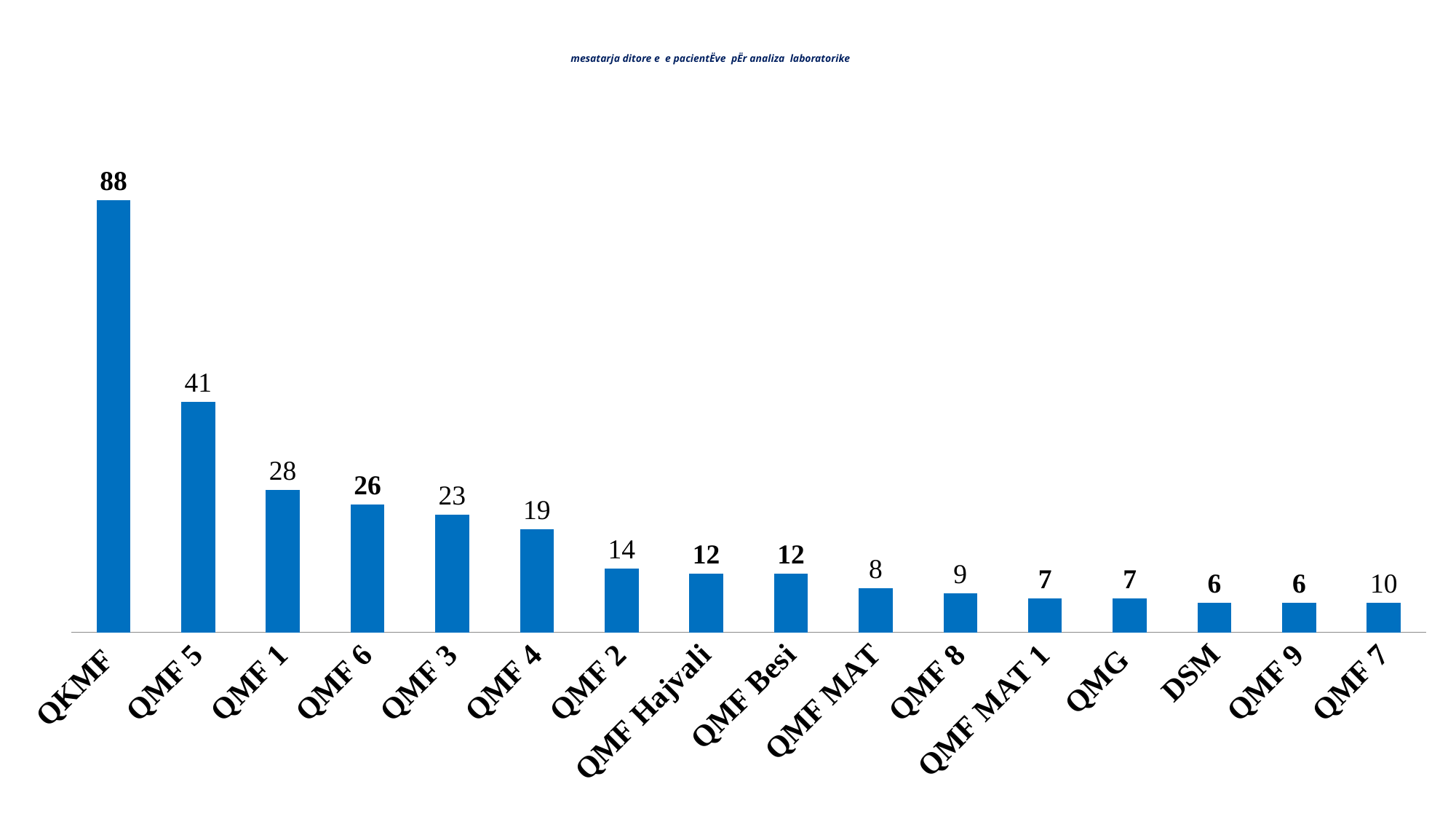
What kind of chart is this? Bar chart What is the value for QMF MAT? 8 Which is larger, the value for QMF 3 or the value for QMF 4? QMF 3 What is the difference between the values for QMF 1 and QMF 6? 2 What is the title of the chart? mesatarja ditore e e pacientËve pËr analiza laboratorike Which category has the highest value? QKMF What is the difference between the values for QKMF and QMF 5? 47 How many categories are shown on the x axis? 16 What is the value for QKMF? 88 What is the value for QMF 7? 10 Which is larger, the value for QMF 8 or the value for QMF 7? QMF 7 What is the value for QMF Hajvali? 12